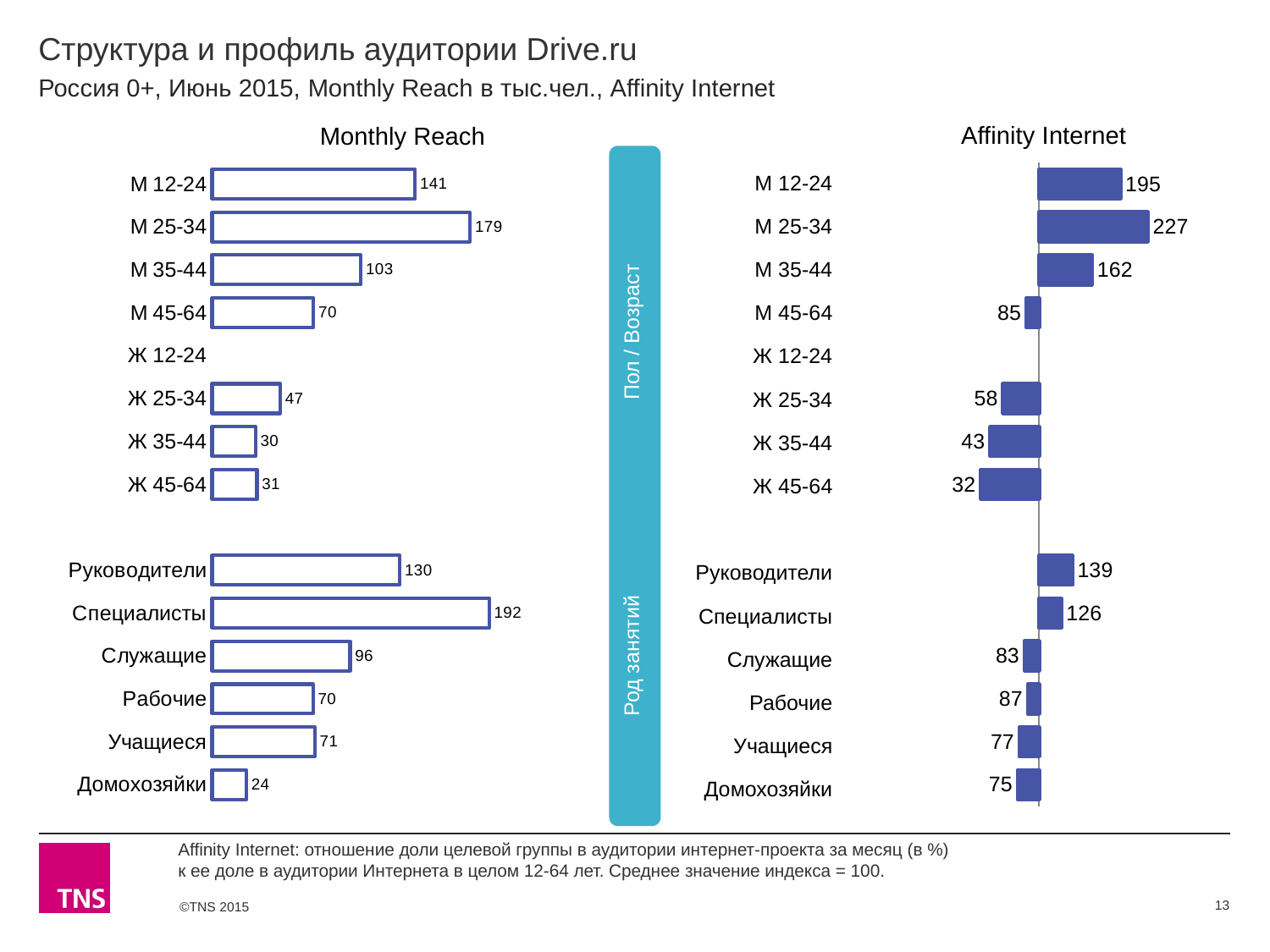
What type of chart is the Monthly Reach chart? Bar chart In the Affinity Internet chart, what is the difference between М 25-34 and М 12-24? 32 In the Monthly Reach chart, what is the difference between М 12-24 and М 35-44? 38 In the Monthly Reach chart, which is larger, Служащие or Рабочие? Служащие In the Affinity Internet chart, what is the value for Ж 45-64? 32 In the Monthly Reach chart, which category has the highest value? Специалисты In the Affinity Internet chart, which is larger, Специалисты or Руководители? Руководители In the Monthly Reach chart, what is the value for Домохозяйки? 24 In the Affinity Internet chart, which category has the highest value? М 25-34 In the Affinity Internet chart, what is the value for Руководители? 139 In the Affinity Internet chart, which category has the lowest value? Ж 45-64 In the Monthly Reach chart, what is the value for М 25-34? 179